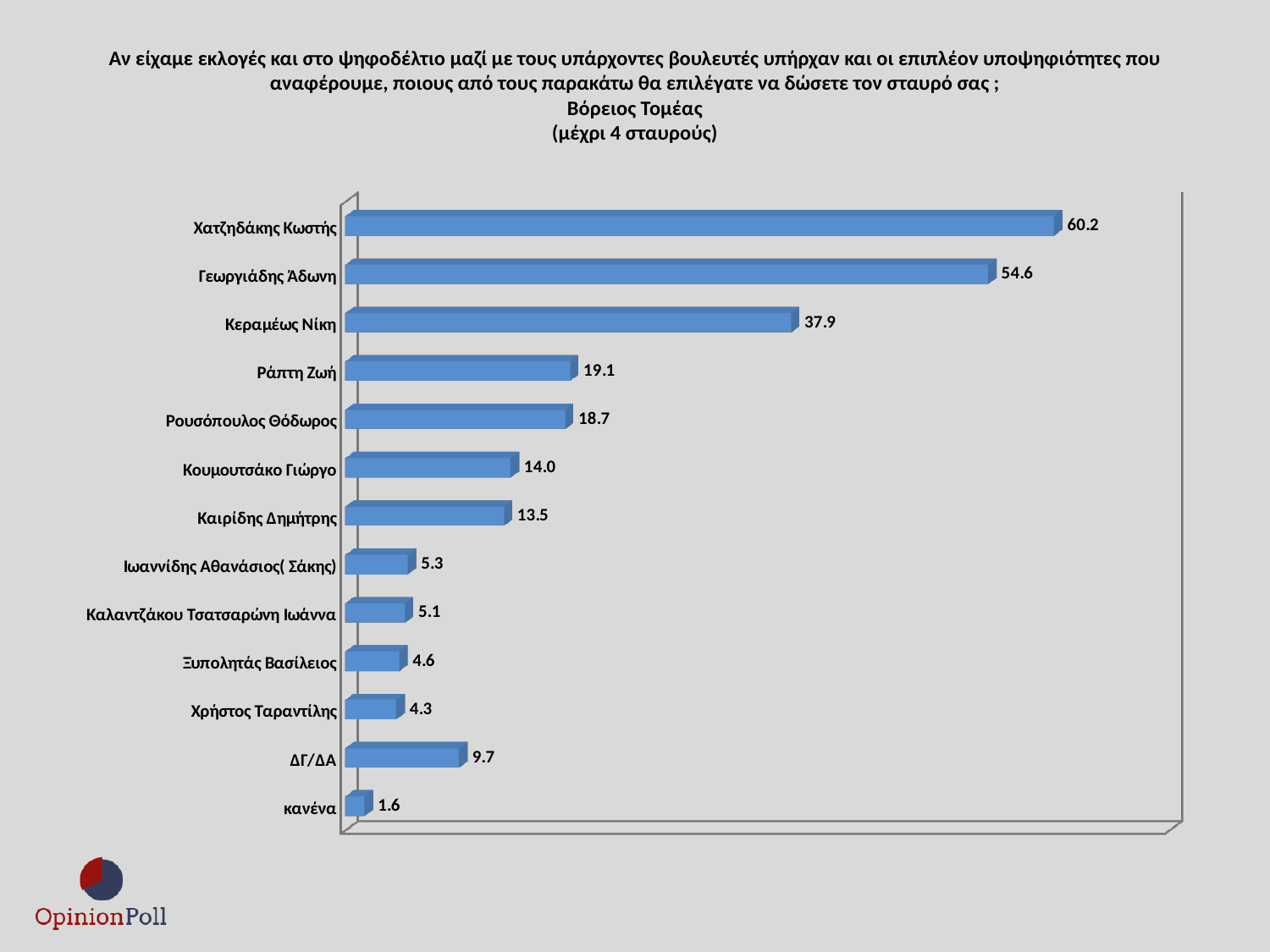
What is the value for Ξυπολητάς Βασίλειος? 4.6 Which is larger, the value for ΔΓ/ΔΑ or the value for Ιωαννίδης Αθανάσιος( Σάκης)? ΔΓ/ΔΑ How many categories are shown in the chart? 13 What kind of chart is shown on the slide? Bar chart What is the value for ΔΓ/ΔΑ? 9.7 What is the difference between the values for Χατζηδάκης Κωστής and Γεωργιάδης Άδωνη? 5.6 Which category has the highest value? Χατζηδάκης Κωστής Which category has the lowest value? κανένα What is the value for Χατζηδάκης Κωστής? 60.2 What is the difference between the values for Ράπτη Ζωή and Ρουσόπουλος Θόδωρος? 0.4 What is the value for Κεραμέως Νίκη? 37.9 Which is larger, the value for Κουμουτσάκο Γιώργο or the value for Καιρίδης Δημήτρης? Κουμουτσάκο Γιώργο